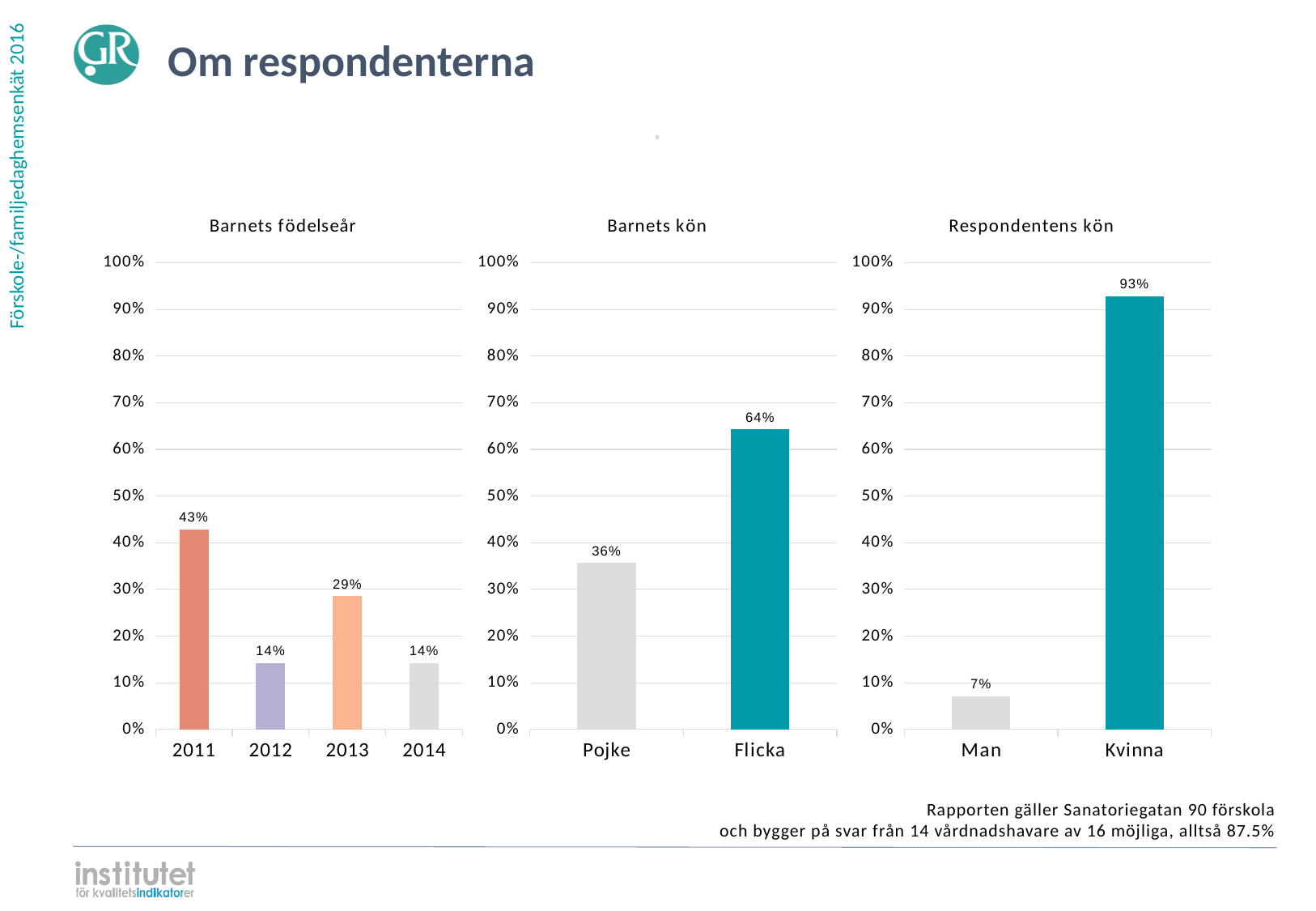
In the 'Barnets födelseår' chart, what is the difference between the values for 2011 and 2013? 14% In the 'Barnets kön' chart, what is the difference between Flicka and Pojke? 28% In the 'Respondentens kön' chart, is the value for Man greater or less than 10%? less What kind of chart is the 'Barnets kön' chart? Bar chart In the 'Barnets födelseår' chart, what is the value for 2013? 29% In the 'Barnets kön' chart, which category is larger, Pojke or Flicka? Flicka In the 'Barnets kön' chart, what is the value for Pojke? 36% In the 'Barnets födelseår' chart, which birth year has the highest value? 2011 In the 'Barnets födelseår' chart, how many categories are shown on the x axis? 4 In the 'Barnets födelseår' chart, what is the value for 2011? 43% In the 'Respondentens kön' chart, what is the value for Kvinna? 93% In the 'Respondentens kön' chart, which category has the lowest value? Man